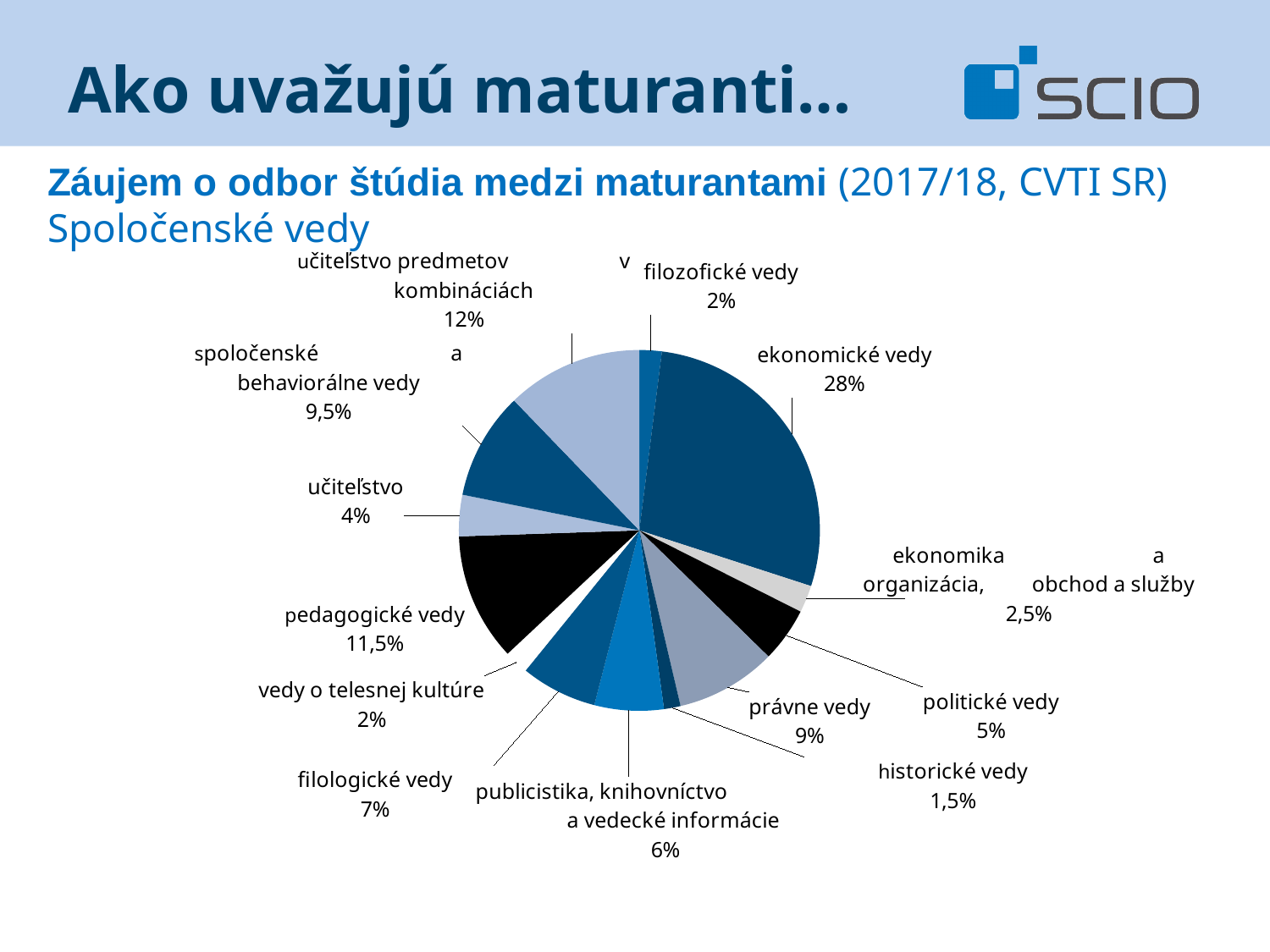
What is the value shown for pedagogické vedy? 11,5% Which field of study does the pie chart cover, according to the subtitle under the chart heading? Spoločenské vedy What is the value shown for historické vedy? 1,5% What is the value shown for publicistika, knihovníctvo a vedecké informácie? 6% What is the value shown for učiteľstvo predmetov v kombináciách? 12% Which category has the smallest share of the pie? historické vedy What is the difference between the shares of ekonomické vedy and právne vedy? 19% Which category has the largest share of the pie? ekonomické vedy What kind of chart is shown on the slide? pie chart Which is larger, the share for filologické vedy or the share for politické vedy? filologické vedy How many categories (slices) does the pie chart have? 13 What share of the pie does ekonomické vedy have? 28%